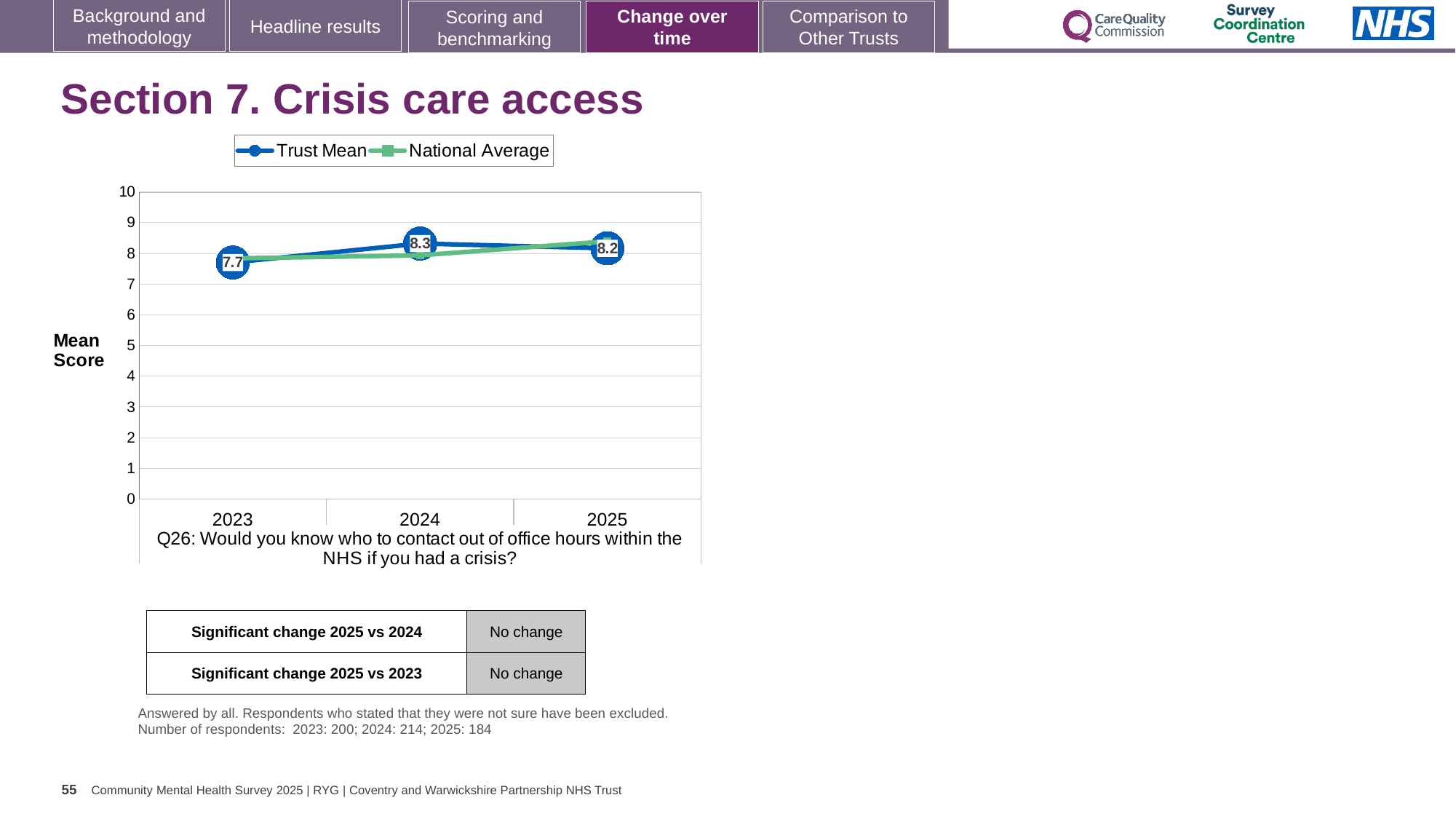
How many years are plotted on the x axis? 3 Does the National Average rise or fall from 2023 to 2025? rise How many series does the legend list? 2 Which is larger, the Trust Mean in 2025 or in 2023? 2025 What kind of chart is shown on the slide? line chart What is the Trust Mean value for 2024? 8.3 What is the Trust Mean value for 2023? 7.7 Is the National Average value for 2025 greater or less than 8? greater In which year is the Trust Mean highest? 2024 What is the Trust Mean value for 2025? 8.2 What is the difference between the Trust Mean in 2024 and in 2023? 0.6 In which year is the Trust Mean lowest? 2023